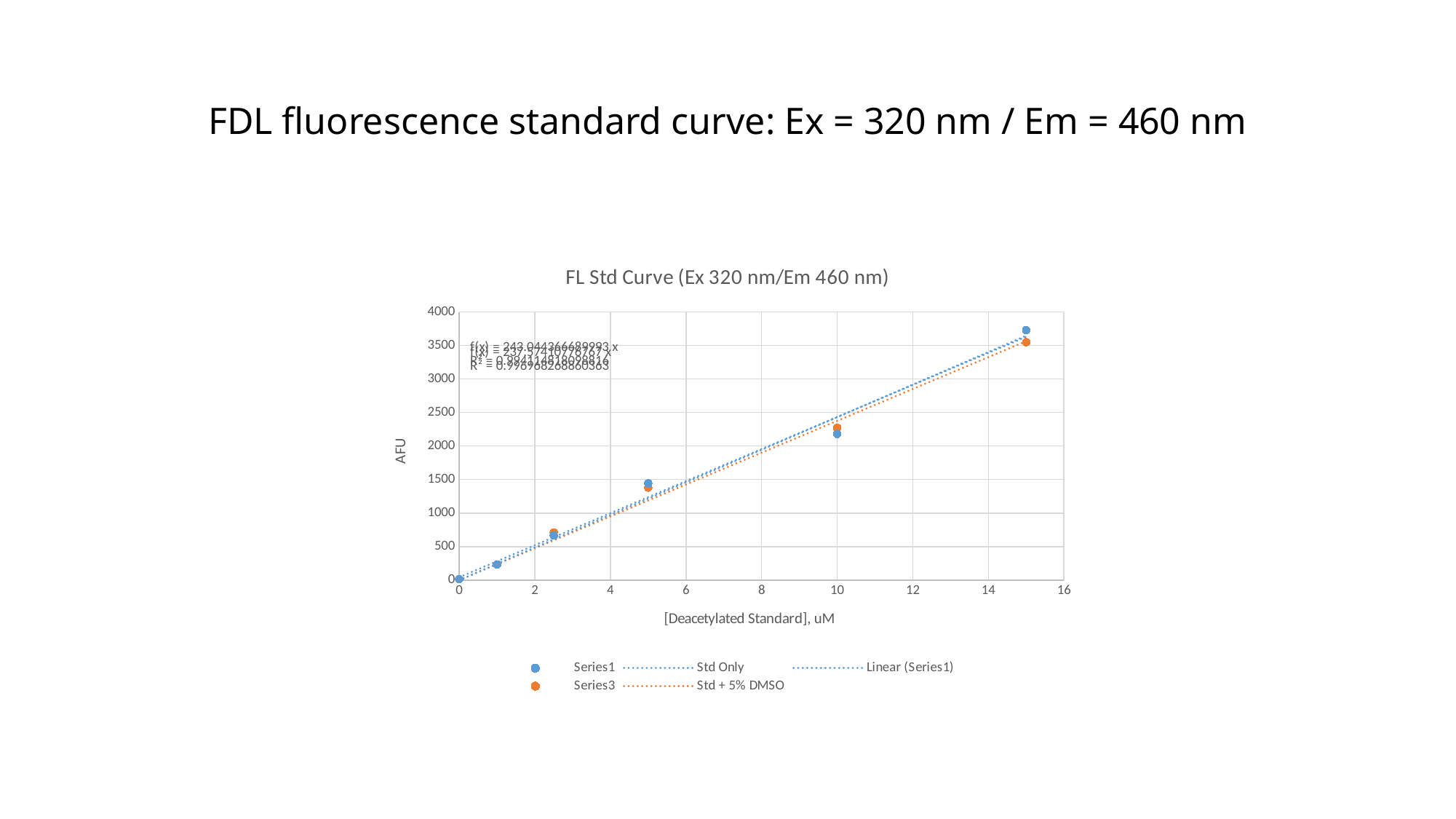
How many data points does the blue Series1 have? 6 Is the Series1 (blue) value at 1 uM greater or less than 500? less Is the Series1 (blue) value at 10 uM greater or less than 2500? less What is the title of the chart? FL Std Curve (Ex 320 nm/Em 460 nm) Do the AFU values rise or fall as the deacetylated standard concentration increases? Rise Is the Series1 (blue) value at 5 uM greater or less than 1000? greater What is the label of the y axis? AFU What kind of chart is shown on the slide? Scatter chart At which concentration does Series1 reach its highest AFU value? 15 At 15 uM, which series has the higher AFU value, Series1 (blue) or Series3 (orange)? Series1